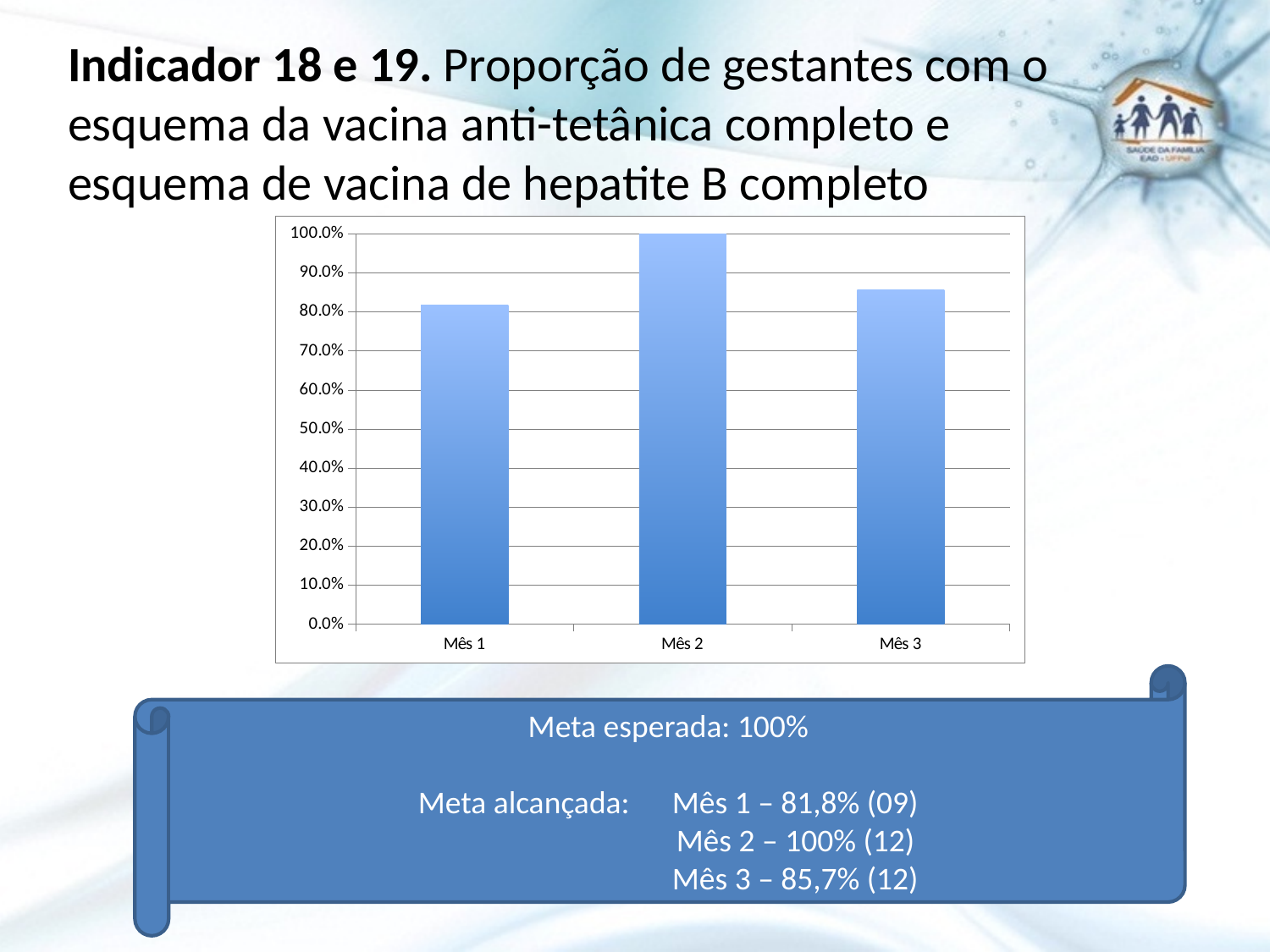
What kind of chart is shown on the slide? bar chart Which month has the highest bar on the chart? Mês 2 What value does the bar for Mês 2 reach on the chart? 100.0% What is the highest tick label shown on the chart's vertical axis? 100.0% Is the value for Mês 1 greater or less than 90.0%? less Which is larger, the value for Mês 1 or the value for Mês 3? Mês 3 Does the value rise or fall from Mês 2 to Mês 3? fall Does the value rise or fall from Mês 1 to Mês 2? rise Is the value for Mês 3 greater or less than 80.0%? greater Which month has the lowest bar on the chart? Mês 1 How many categories (months) are plotted on the chart? 3 Is the value for Mês 1 greater or less than 70.0%? greater